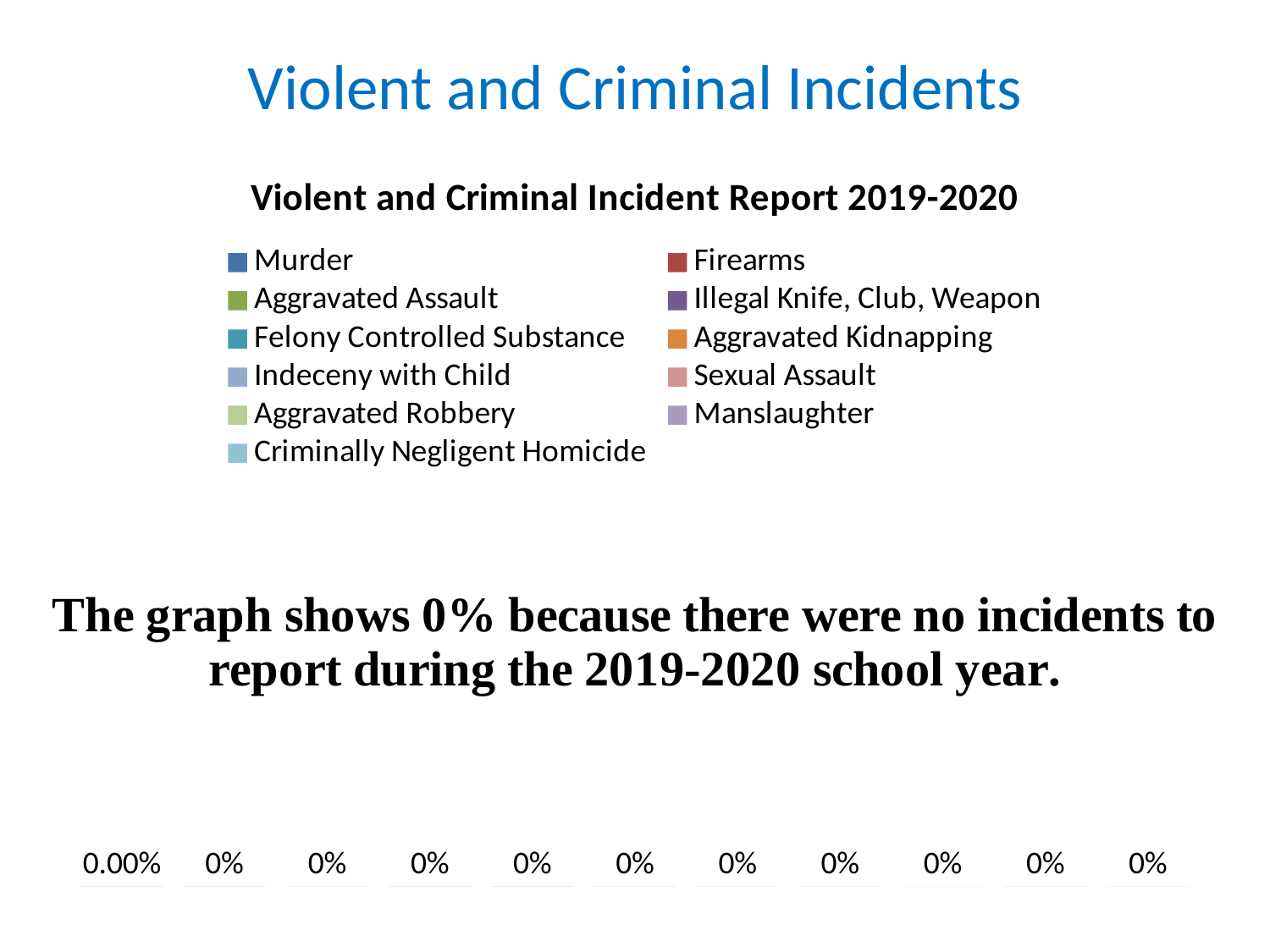
What value is shown for Criminally Negligent Homicide? 0% Do the values rise, fall, or stay the same across the categories? stay the same Which legend entry is listed first in the chart legend? Murder How many data labels are shown along the bottom of the chart? 11 What value is shown for Aggravated Assault? 0% What is the difference between the values for Firearms and Manslaughter? 0% What is the title of the chart? Violent and Criminal Incident Report 2019-2020 What value is shown for Sexual Assault? 0% What value is shown for Firearms? 0% How many series does the chart legend list? 11 Is the value for Aggravated Kidnapping greater or less than 50%? less What is the leftmost data label shown on the chart? 0.00%